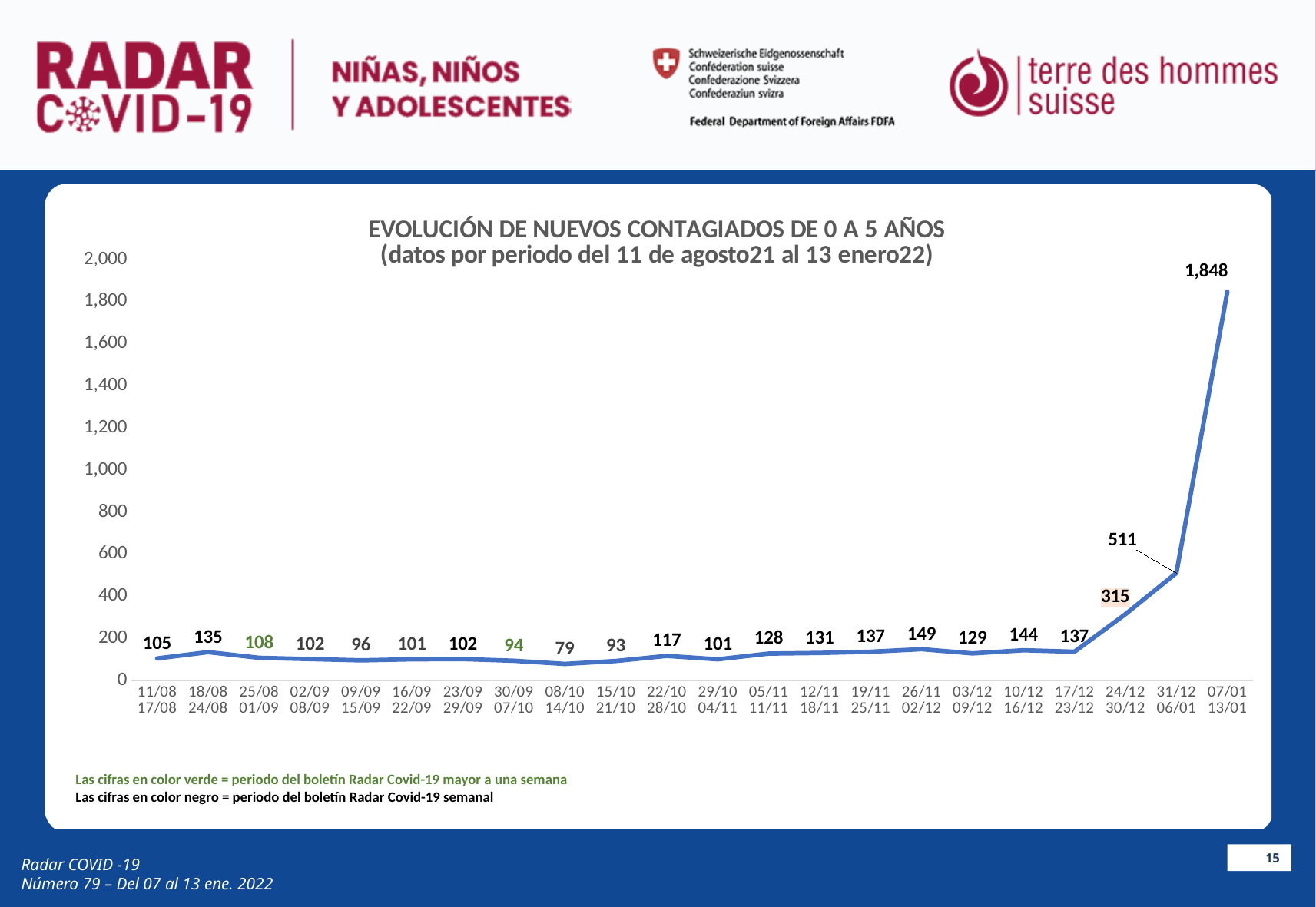
What is the value for the period 07/01–13/01? 1,848 Which period has the lowest value? 08/10–14/10 What is the difference between the values for 07/01–13/01 and 31/12–06/01? 1,337 Do the values rise or fall over the last three periods of the chart? rise What type of chart is shown on the slide? line chart Which is larger, the value for 18/08–24/08 or the value for 25/08–01/09? 18/08–24/08 According to the note below the chart, what do the figures in green indicate? periodo del boletín Radar Covid-19 mayor a una semana How many periods (data points) are plotted on the chart? 22 What is the difference between the values for 31/12–06/01 and 24/12–30/12? 196 What is the value for the period 26/11–02/12? 149 Which period has the highest value? 07/01–13/01 What is the value for the period 24/12–30/12? 315